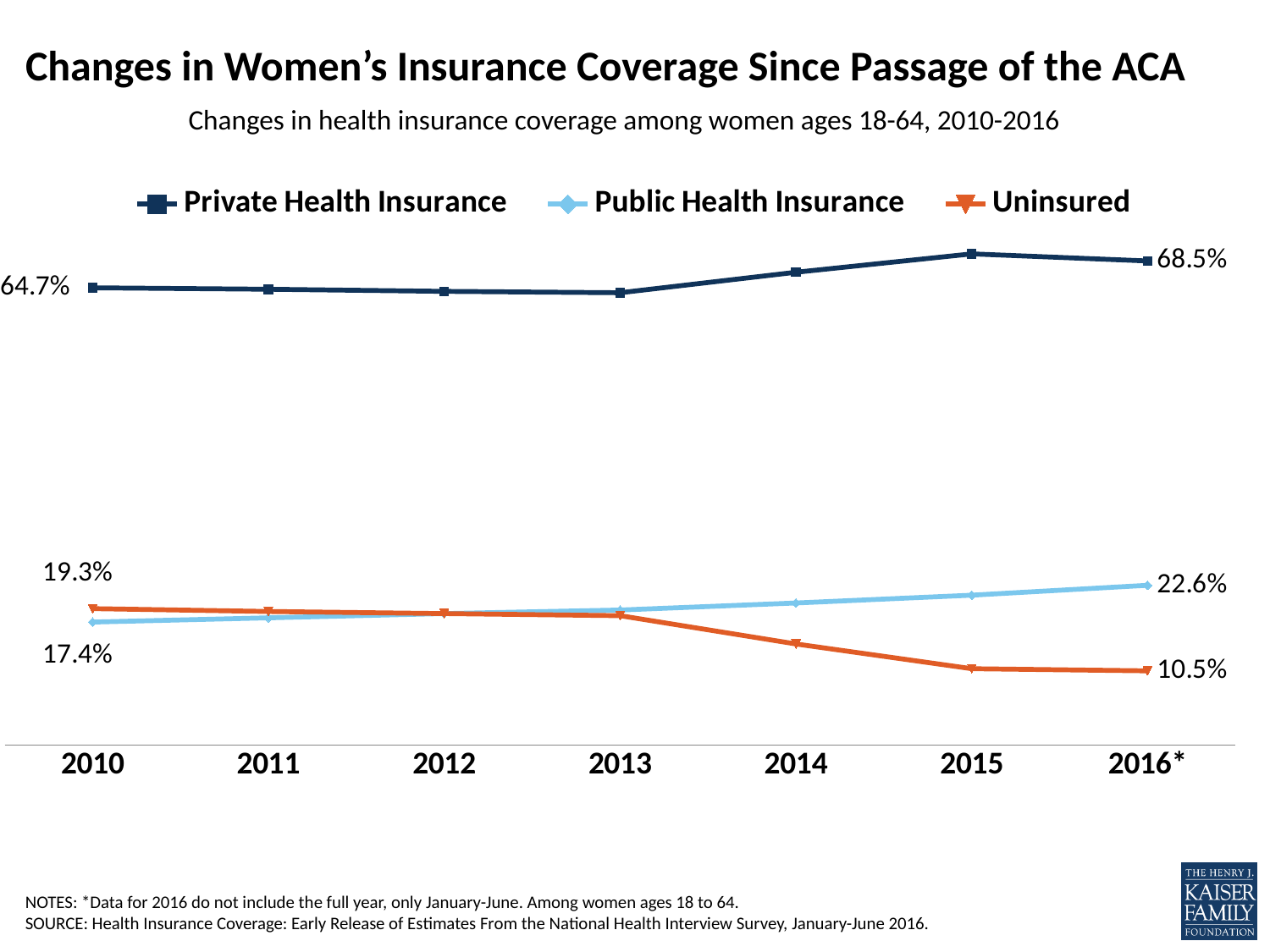
What was the Public Health Insurance value in 2010? 17.4% By how many percentage points did Public Health Insurance coverage change from 2010 to 2016*? 5.2 percentage points higher Which series has the highest value in 2016*? Private Health Insurance What kind of chart is shown on the slide? Line chart Does the Uninsured line rise or fall from 2013 to 2016*? Fall How many years are shown on the x axis? 7 What was the Private Health Insurance value in 2010? 64.7% What was the Uninsured value in 2016*? 10.5% What was the Private Health Insurance value in 2016*? 68.5% In 2010, which was larger: Public Health Insurance or Uninsured? Uninsured By how many percentage points did the Uninsured share change from 2010 to 2016*? 8.8 percentage points lower How many series does the legend list? 3